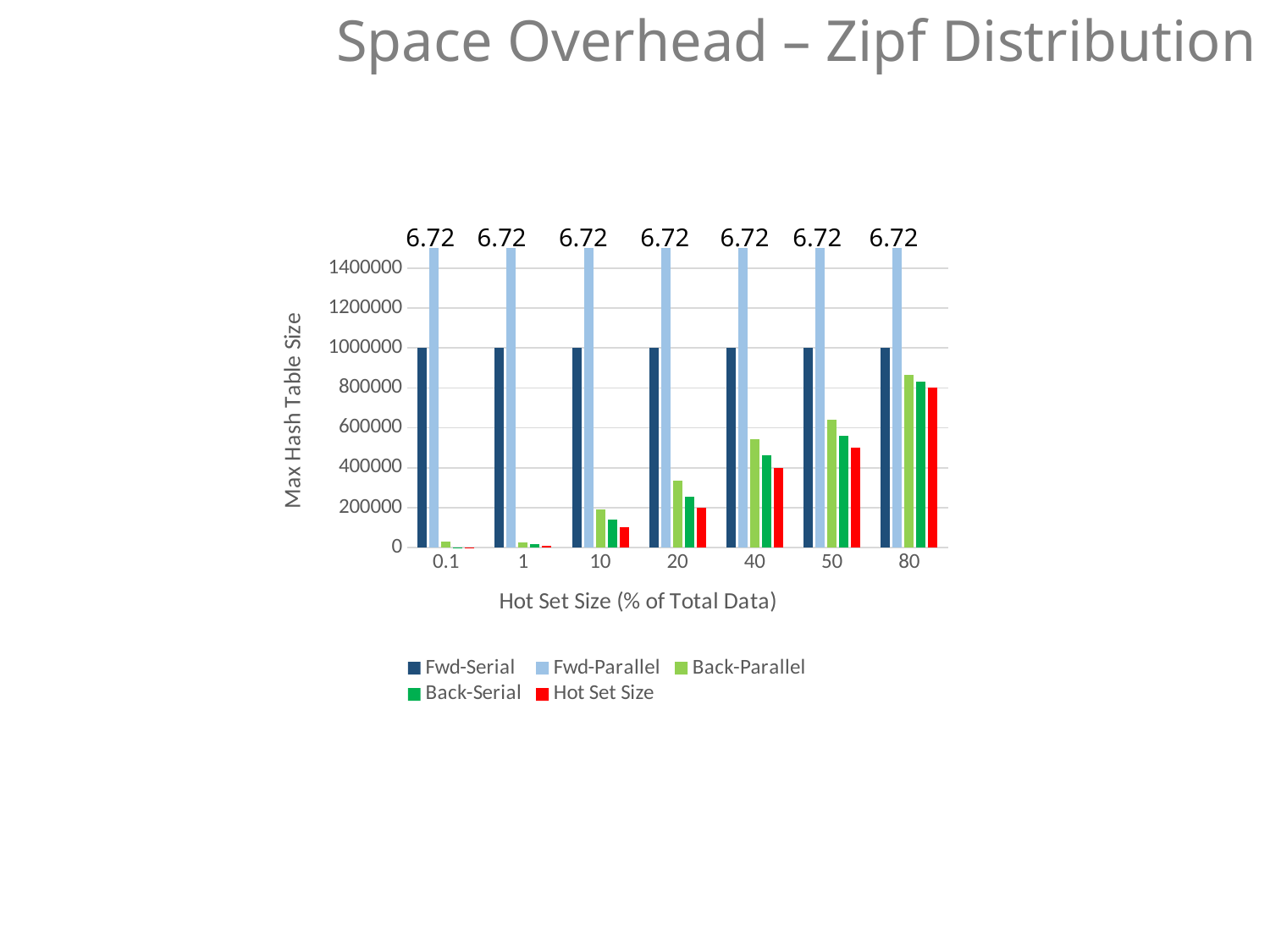
What is the value of Hot Set Size at a hot set size of 40? 400000 Do the Hot Set Size values rise or fall as the hot set size increases along the x axis? rise Is the value for Back-Parallel at a hot set size of 80 greater or less than 800000? greater What data label is printed above the Fwd-Parallel bar at a hot set size of 20? 6.72 Is the value for Back-Serial at a hot set size of 10 greater or less than 200000? less What is the value of Hot Set Size at a hot set size of 80? 800000 What is the label of the y axis? Max Hash Table Size How many series does the legend list? 5 At a hot set size of 50, which is larger, Back-Parallel or Back-Serial? Back-Parallel What is the value of Fwd-Serial at a hot set size of 10? 1000000 How many hot set size categories are shown on the x axis? 7 What kind of chart is shown on the slide? bar chart